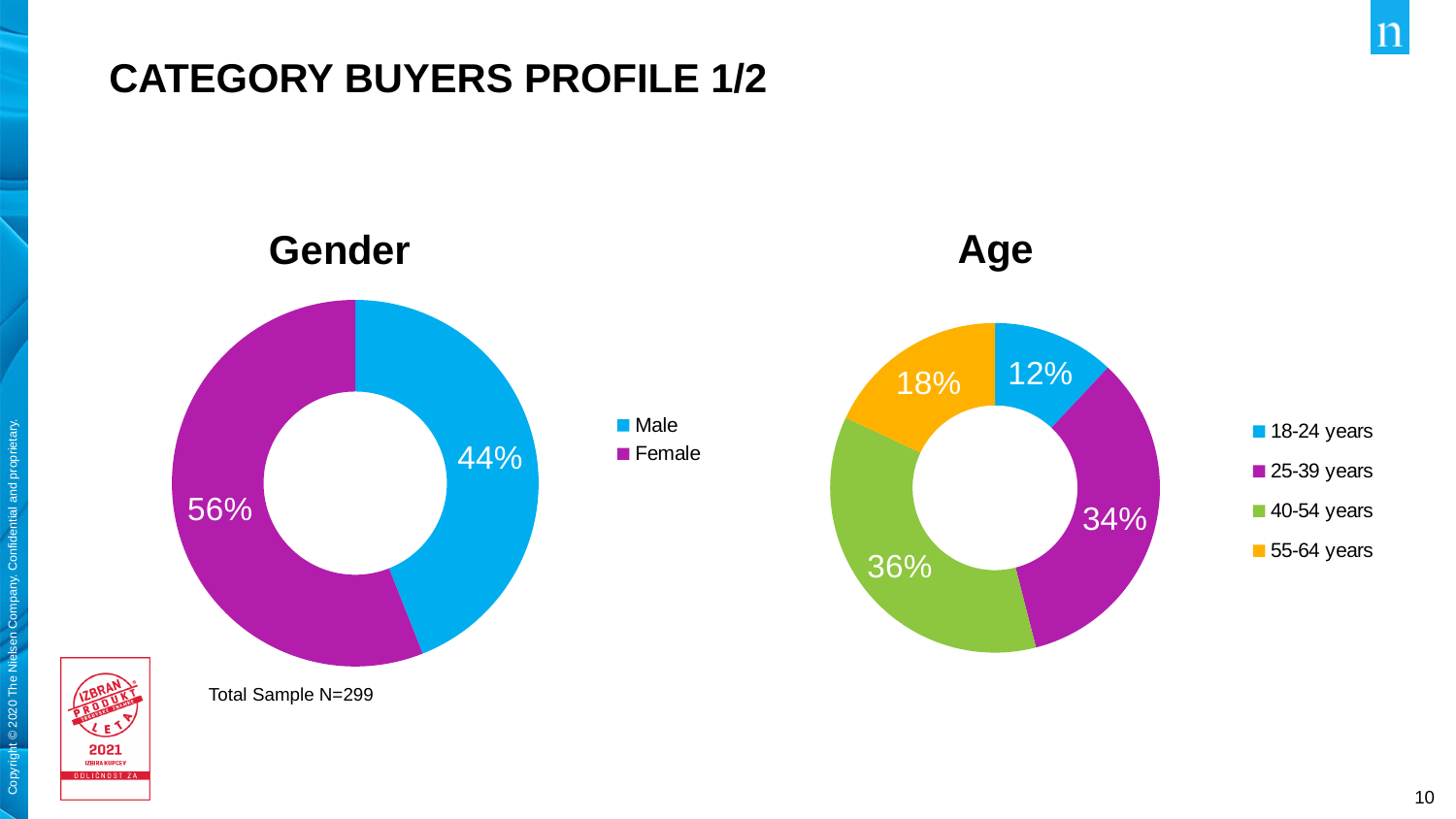
In the Gender chart, what is the difference in percentage points between Female and Male? 12 What type of chart is the Gender chart? Doughnut chart How many age groups does the Age chart's legend list? 4 In the Age chart, what is the difference in percentage points between the 40-54 years and 18-24 years groups? 24 In the Age chart, what percentage of buyers are 40-54 years old? 36% In the Age chart, which age group has the smallest share? 18-24 years In the Age chart, which age group has the largest share? 40-54 years In the Gender chart, which gender has the larger share? Female In the Gender chart, what percentage of category buyers are Female? 56% In the Gender chart, what percentage of category buyers are Male? 44% In the Age chart, which is larger: the share of 25-39 years or the share of 55-64 years? 25-39 years In the Age chart, what percentage of buyers are 18-24 years old? 12%